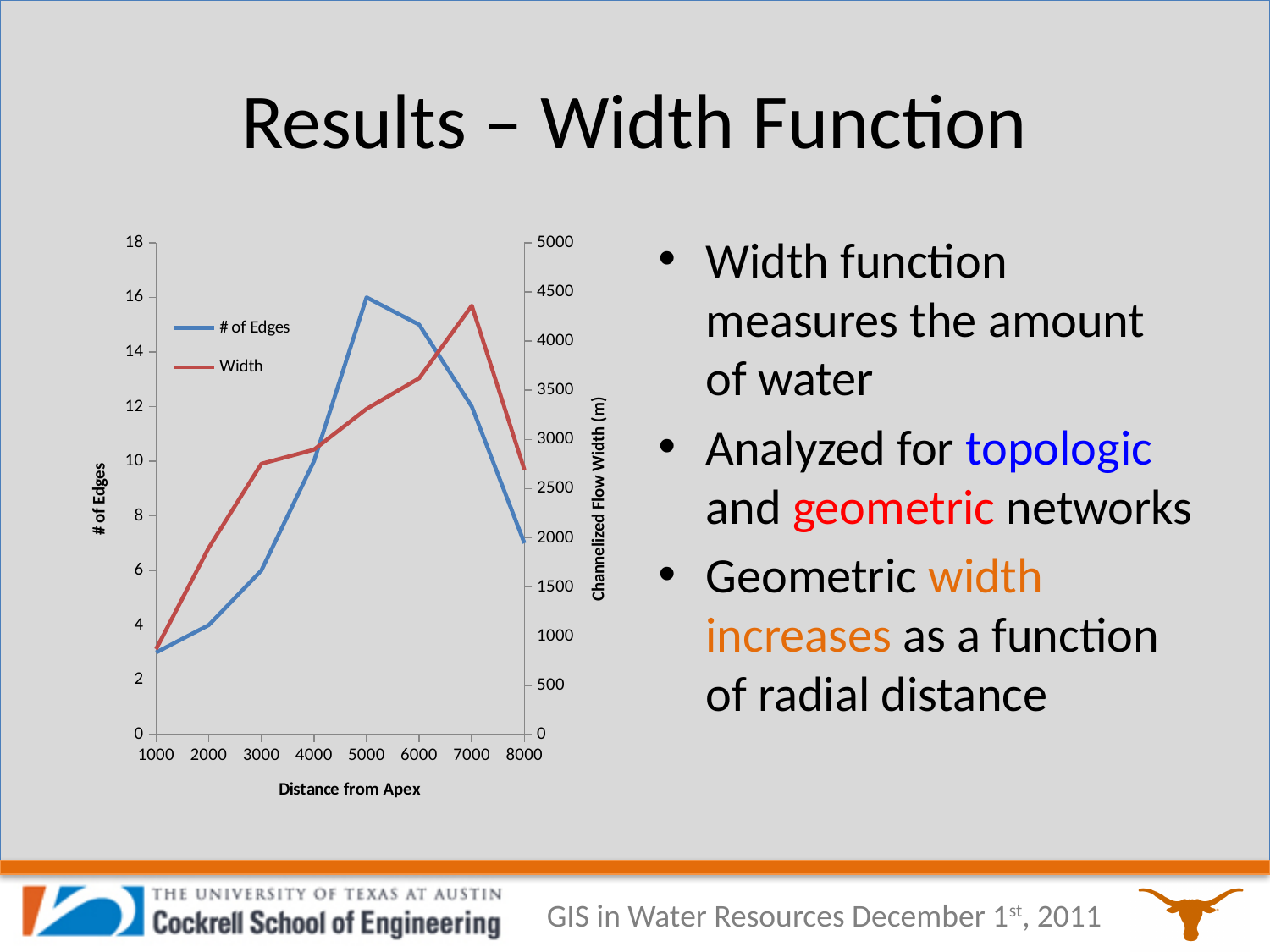
How many distance points are plotted along the x axis? 8 At which distance from apex is the Width highest? 7000 At which distance from apex is the # of Edges lowest? 1000 How many series does the chart's legend list? 2 What is the title of the right-hand vertical axis? Channelized Flow Width (m) What is the # of Edges value at a distance from apex of 4000? 10 What is the # of Edges value at a distance from apex of 7000? 12 At which distance from apex is the # of Edges highest? 5000 What is the difference in # of Edges between distances 5000 and 4000? 6 What is the # of Edges value at a distance from apex of 5000? 16 Is the Width value at a distance from apex of 7000 greater or less than 4000? greater What type of chart is shown on the slide? Line chart